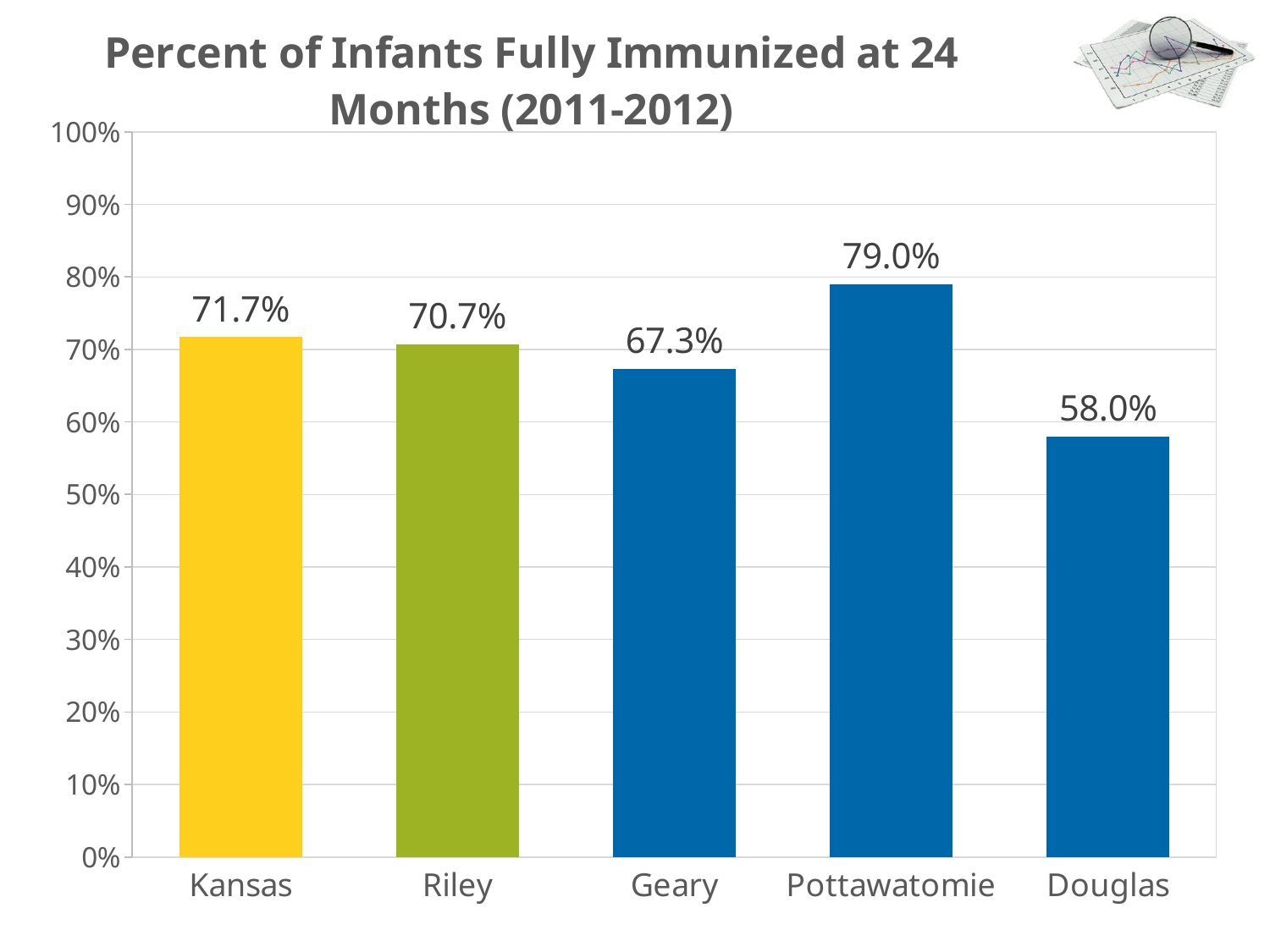
Is the value for Douglas greater or less than 60%? less What is the value for Geary? 67.3% What is the difference between the values for Kansas and Riley? 1.0% What is the difference between the values for Pottawatomie and Douglas? 21.0% How many categories are shown on the x axis? 5 What kind of chart is shown on the slide? Bar chart What is the value for Kansas? 71.7% What is the value for Douglas? 58.0% Which category has the lowest value? Douglas Which category has the highest value? Pottawatomie What is the value for Pottawatomie? 79.0% Which is larger, the value for Riley or the value for Geary? Riley